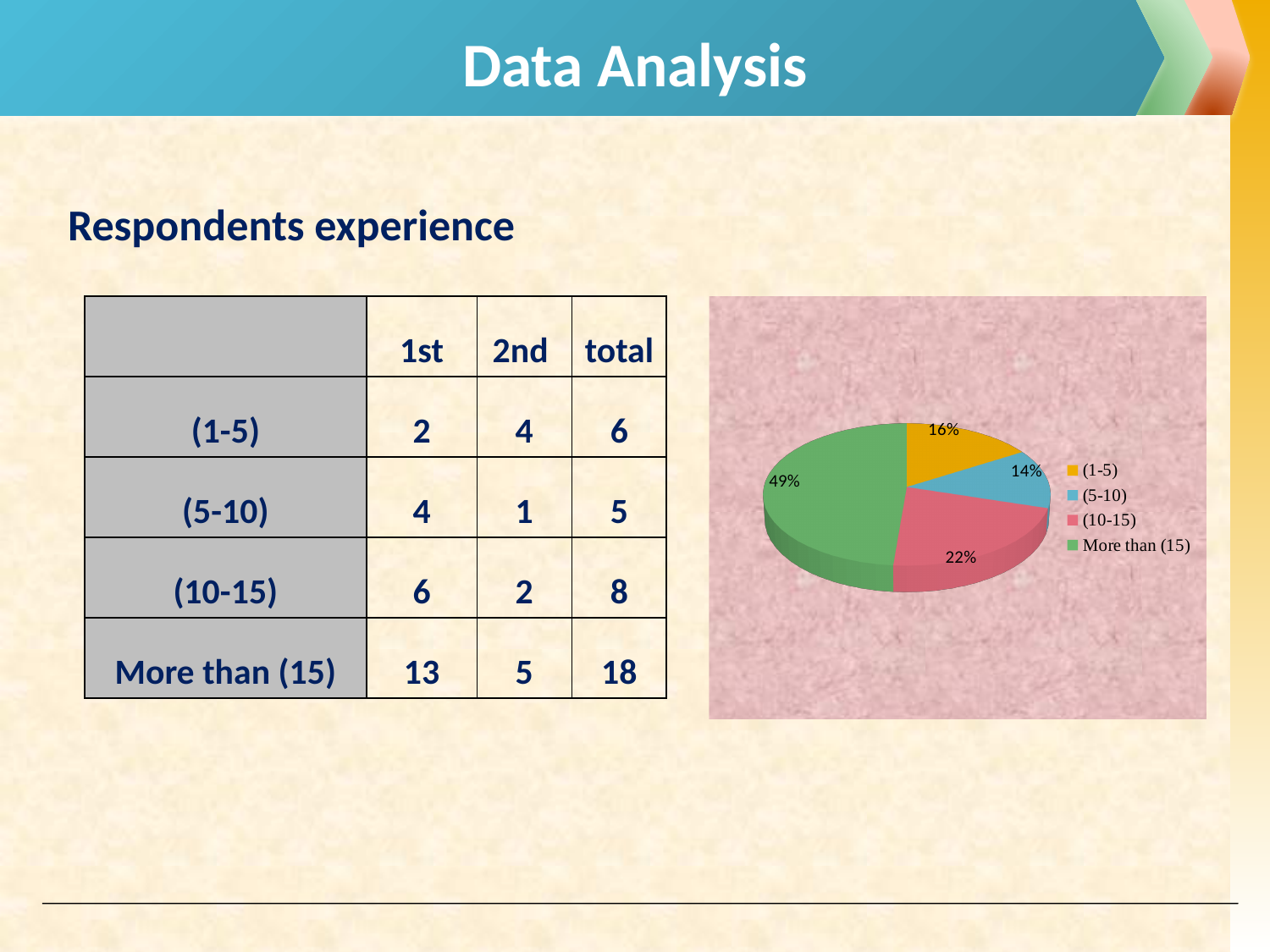
How many categories does the pie chart show? 4 What percentage does the pie chart show for the More than (15) category? 49% Which category has the largest slice in the pie chart? More than (15) What kind of chart is shown on the slide? pie chart What percentage does the pie chart show for the (5-10) category? 14% What is the difference in percentage points between the More than (15) slice and the (10-15) slice? 27 How many entries does the pie chart's legend list? 4 What colour is the More than (15) slice in the pie chart? green Which slice is larger in the pie chart, (1-5) or (10-15)? (10-15) Which category has the smallest slice in the pie chart? (5-10) What percentage does the pie chart show for the (1-5) category? 16% What percentage does the pie chart show for the (10-15) category? 22%